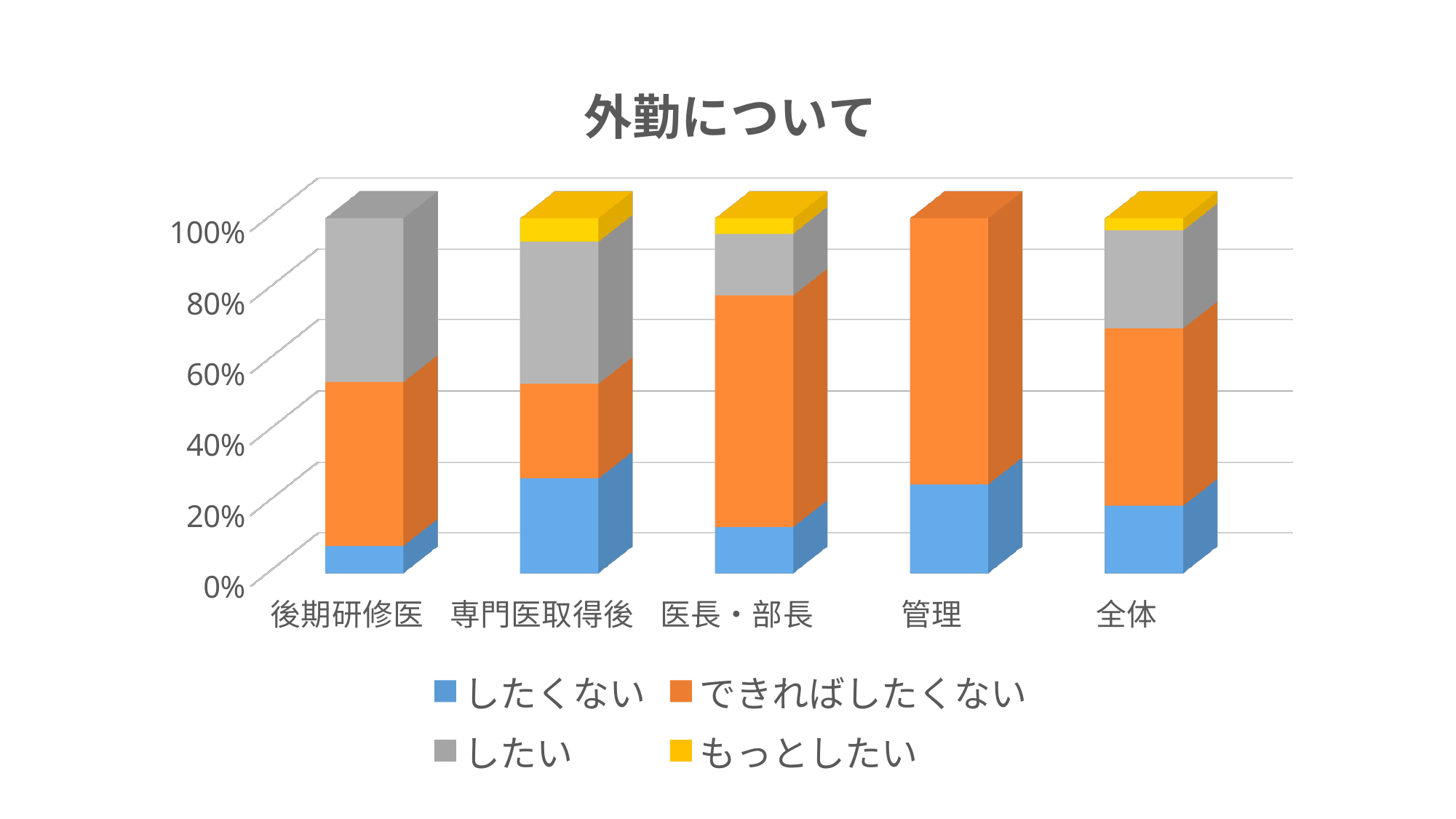
Which has the larger できればしたくない share, 医長・部長 or 後期研修医? 医長・部長 Which category has the smallest したくない share? 後期研修医 How many categories are shown on the x axis? 5 Which category has the largest できればしたくない share? 管理 How many series does the legend list? 4 What kind of chart is shown on the slide? Stacked bar chart What is the title of the chart? 外勤について Is the できればしたくない share for 管理 greater or less than 60%? greater Which colour represents the したい series? Gray Is the したくない share for 後期研修医 greater or less than 20%? less Which category has no したい segment at all? 管理 Which has the larger したくない share, 専門医取得後 or 医長・部長? 専門医取得後